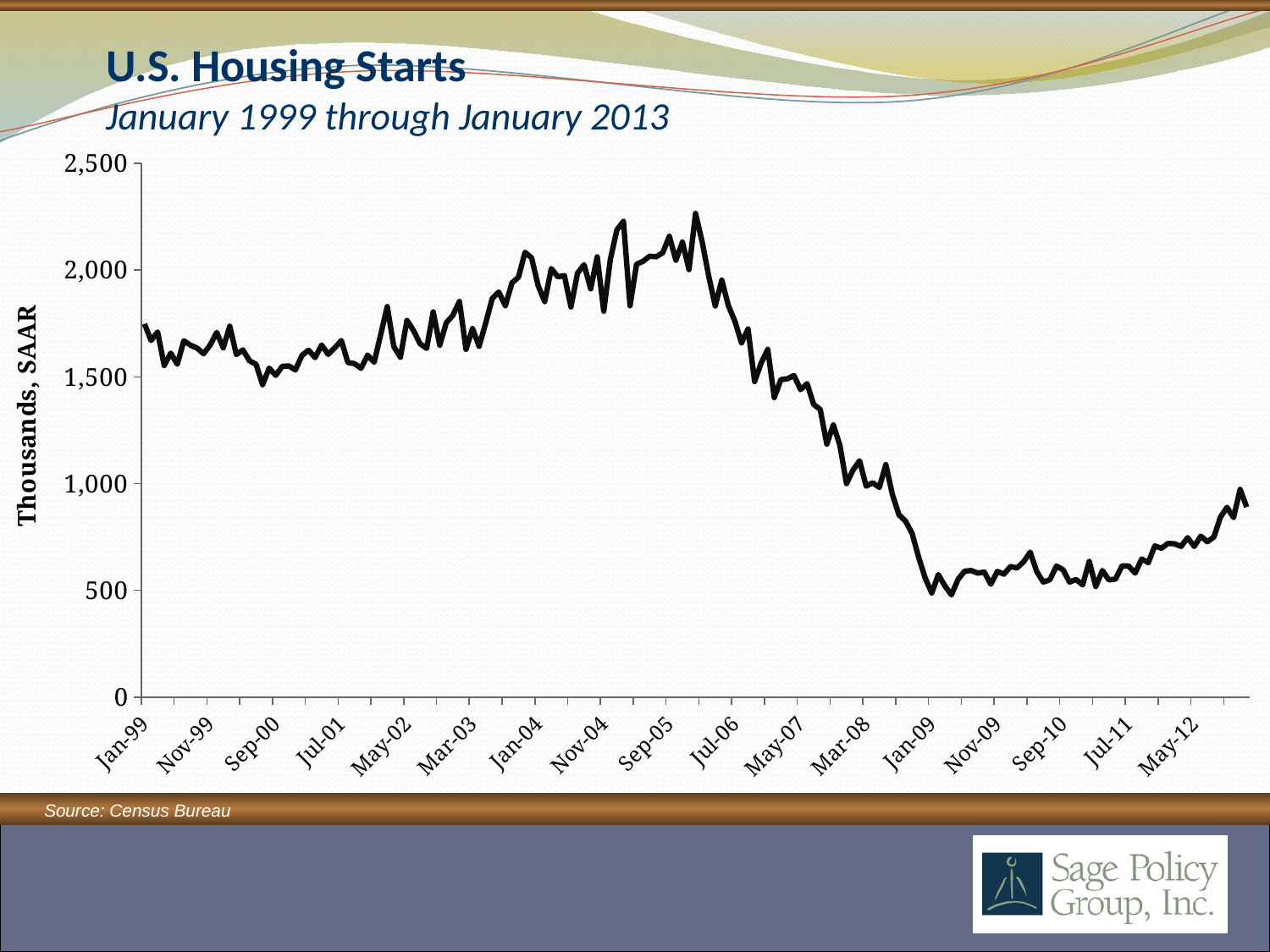
Does the line rise or fall between Jul-06 and Jan-09? fall Is the value for Nov-09 greater or less than 1,000? less Is the value for Sep-10 greater or less than 1,000? less How many date labels are shown along the x axis? 17 What is the label on the vertical axis? Thousands, SAAR What is the title of the chart? U.S. Housing Starts Does the line rise or fall between Jan-09 and the end of the series in January 2013? rise Is the value for Jan-99 greater or less than 1,500? greater What kind of chart is shown on the slide? line chart